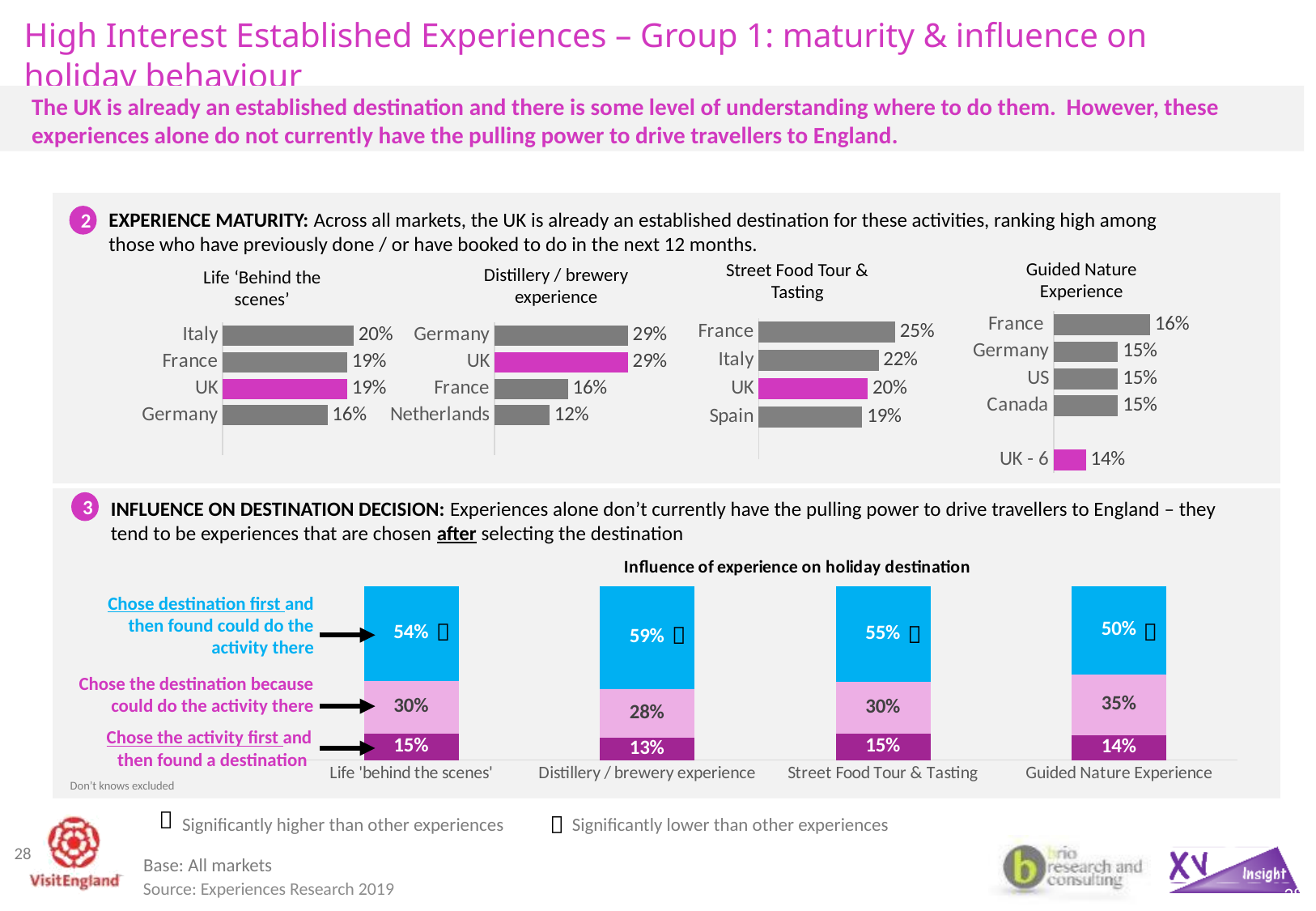
In the Distillery / brewery experience chart, what is the value for Netherlands? 12% In the Guided Nature Experience chart, what is the value for France? 16% In the Life 'Behind the scenes' chart, what is the value for Italy? 20% In the 'Influence of experience on holiday destination' chart, what is the total of the Distillery / brewery experience bar? 100% In the Distillery / brewery experience chart, what is the difference between Germany and Netherlands? 17 percentage points How many markets are shown in the Life 'Behind the scenes' chart? 4 In the 'Influence of experience on holiday destination' chart, what is the 'Chose the destination because could do the activity there' value for Guided Nature Experience? 35% In the Guided Nature Experience chart, which market has the lowest value? UK In the Street Food Tour & Tasting chart, which market has the highest value? France In the Street Food Tour & Tasting chart, which is larger, Italy or UK? Italy What kind of chart is the 'Influence of experience on holiday destination' chart? Stacked bar chart In the 'Influence of experience on holiday destination' chart, which experience has the highest 'Chose destination first and then found could do the activity there' value? Distillery / brewery experience